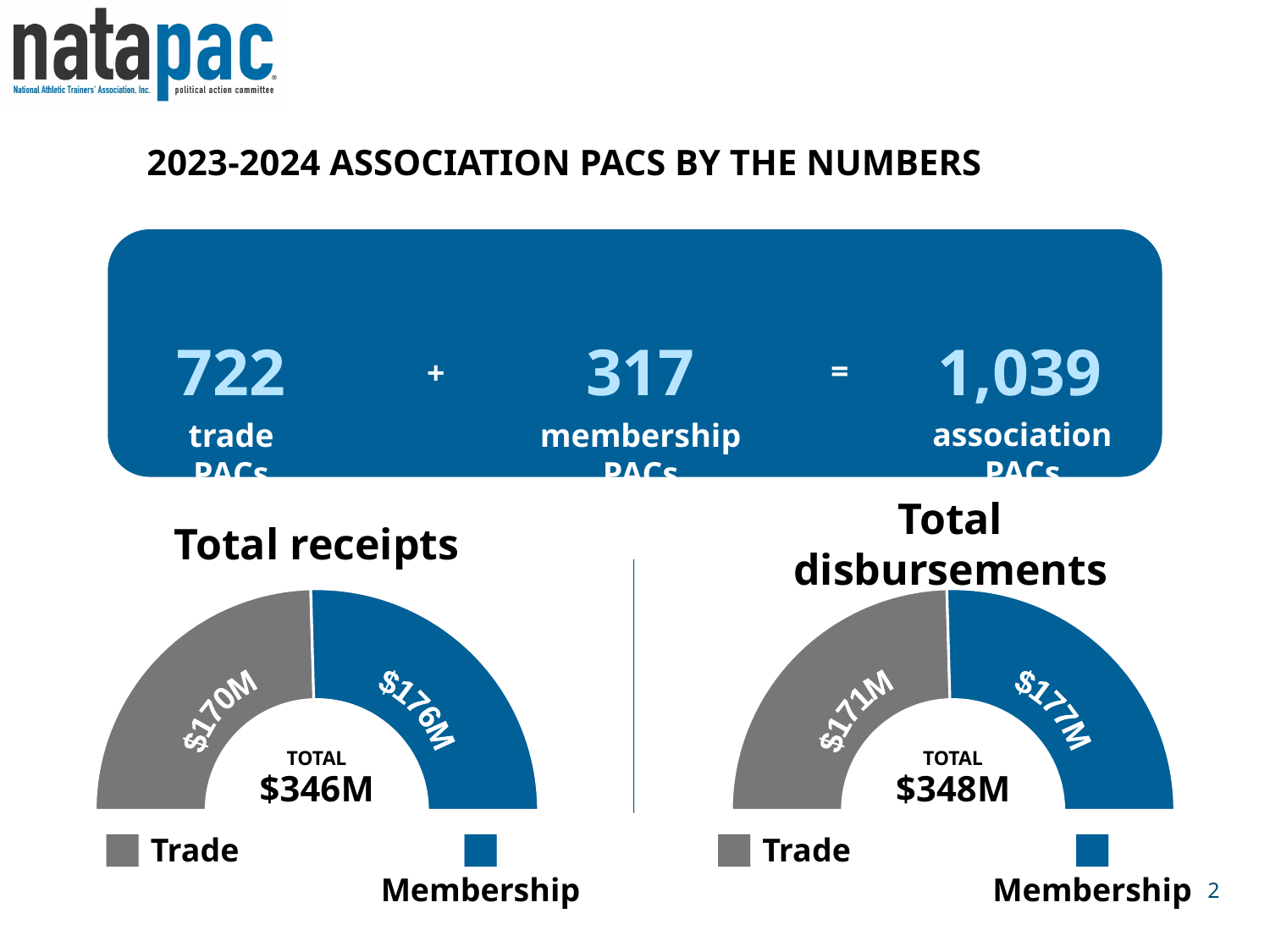
In the Total receipts chart, what is the total shown in the centre? $346M How many segments does the Total disbursements chart have? 2 What kind of chart is used for Total receipts? Donut chart In the Total receipts chart, which segment is larger, Trade or Membership? Membership In the Total receipts chart, what is the value for Trade? $170M In the Total disbursements chart, what is the total shown in the centre? $348M In the Total disbursements chart, what is the value for Trade? $171M In the Total disbursements chart, what is the value for Membership? $177M In the Total receipts chart, what is the value for Membership? $176M In the Total receipts chart, what is the difference between the Membership and Trade values? $6M In the Total disbursements chart, which colour represents Trade? Grey In the Total disbursements chart, what is the difference between the Membership and Trade values? $6M